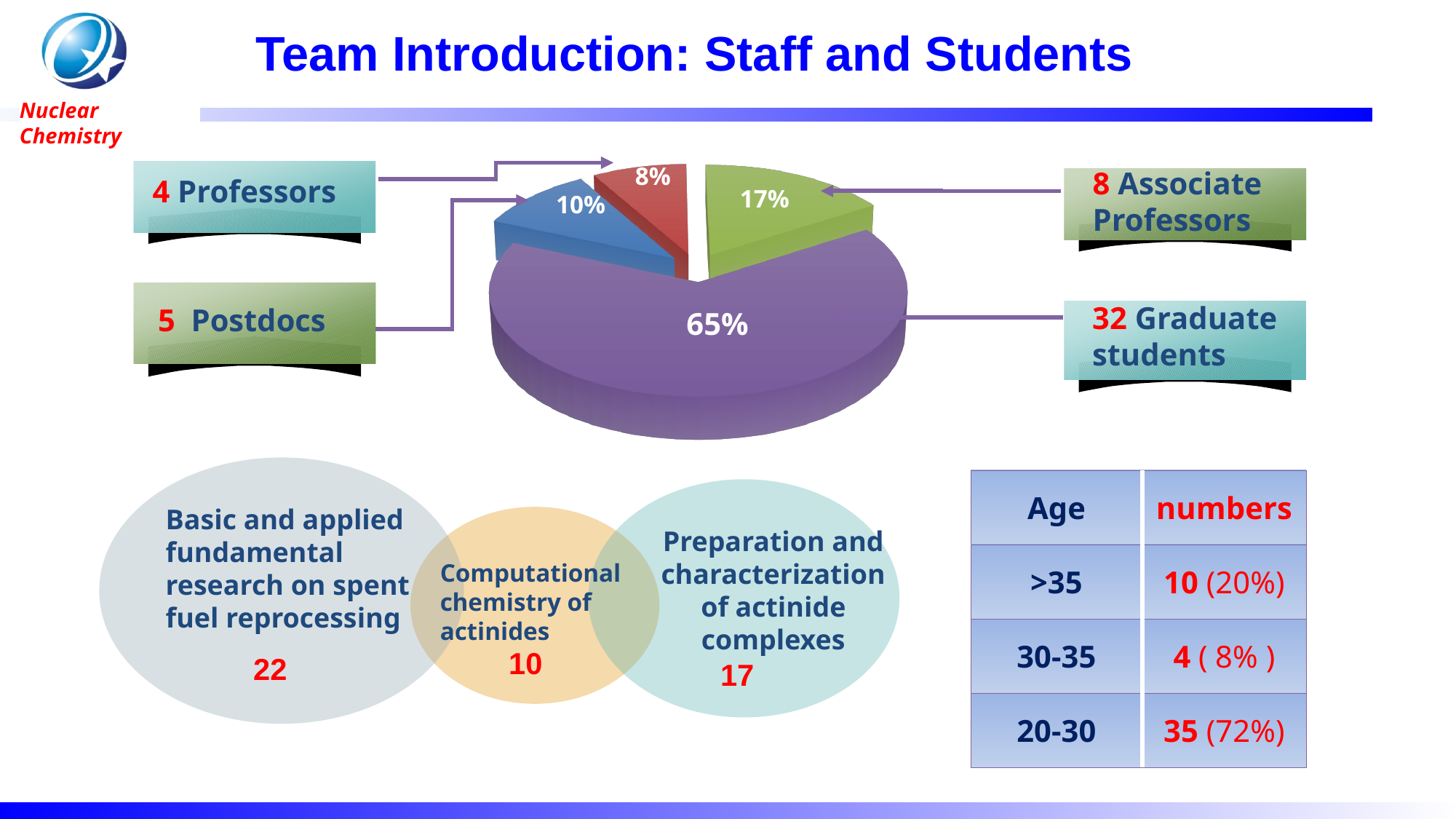
How many slices does the pie chart have? 4 What percentage of the pie chart is labelled for Graduate students? 65% What colour is the Graduate students slice in the pie chart? purple What percentage of the pie chart is labelled for Associate Professors? 17% Which group has the smallest slice of the pie chart? Professors What percentage of the pie chart is labelled for Postdocs? 10% Which group has the largest slice of the pie chart? Graduate students What kind of chart is shown in the upper part of the slide? pie chart What percentage of the pie chart is labelled for Professors? 8% How many Graduate students are indicated in the box linked to the 65% slice? 32 In the pie chart, which slice is larger: Associate Professors or Postdocs? Associate Professors What is the difference in percentage points between the Graduate students slice and the Associate Professors slice? 48